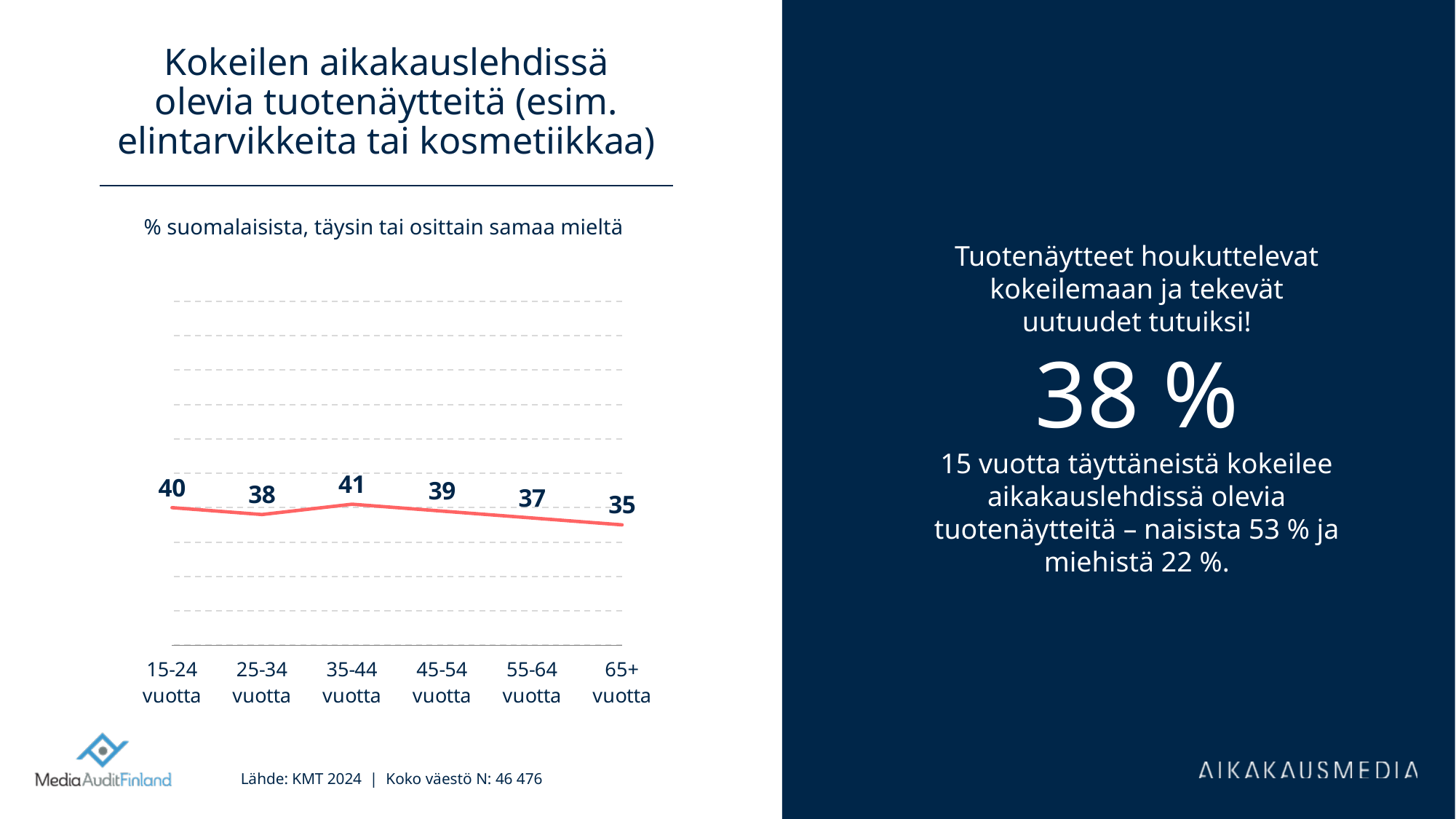
What is the value for the 65+ vuotta age group? 35 What is the difference between the values for 35-44 vuotta and 65+ vuotta? 6 What is the subtitle shown above the chart? % suomalaisista, täysin tai osittain samaa mieltä What is the value for the 35-44 vuotta age group? 41 What is the value for the 15-24 vuotta age group? 40 What kind of chart is shown on the slide? Line chart Do the values generally rise or fall from the 35-44 vuotta group to the 65+ vuotta group? Fall Which age group has the highest value? 35-44 vuotta Which age group has the lowest value? 65+ vuotta Which is larger, the value for 25-34 vuotta or the value for 45-54 vuotta? 45-54 vuotta What is the difference between the values for 15-24 vuotta and 25-34 vuotta? 2 How many age groups are plotted on the chart? 6